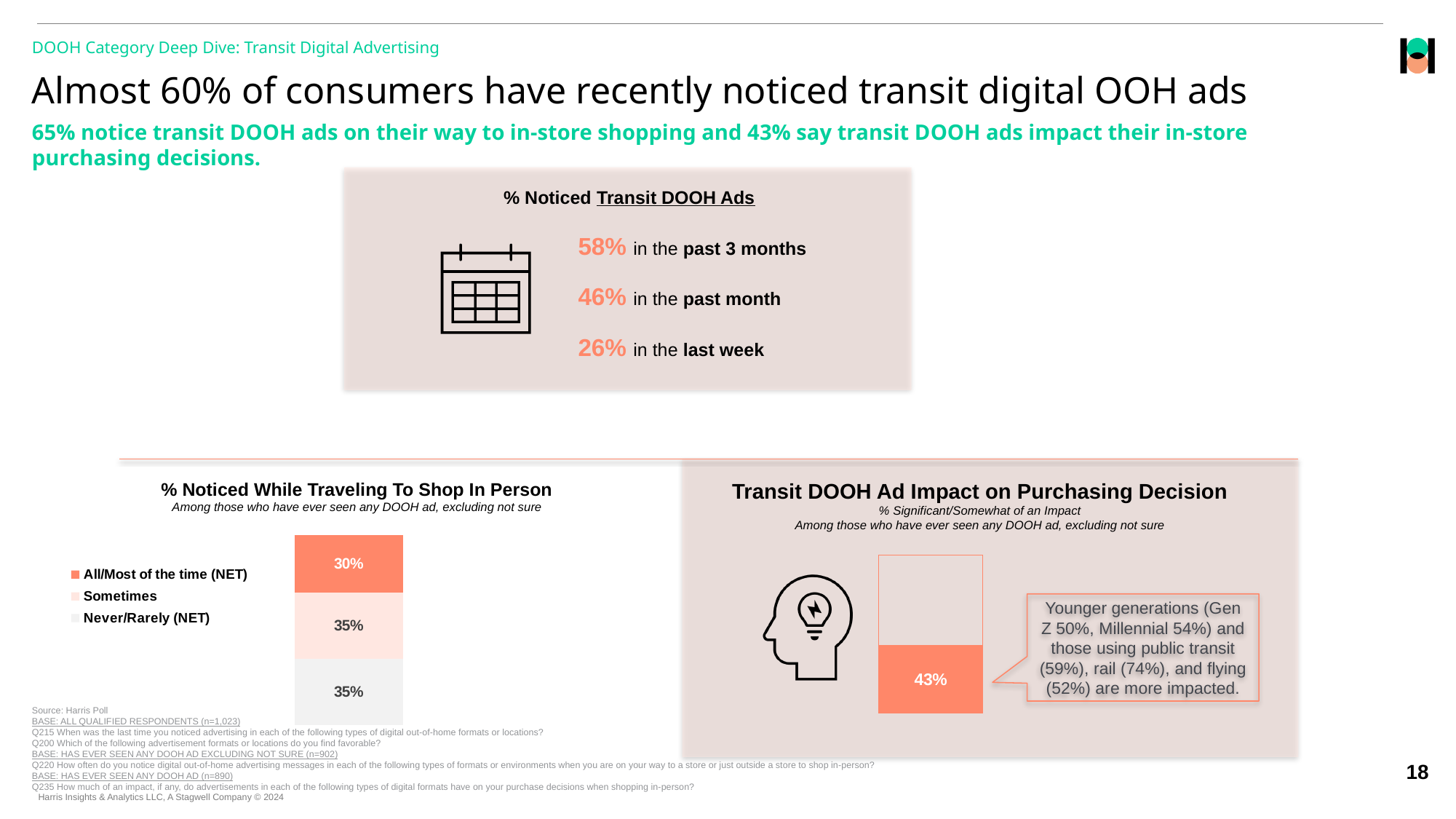
In the '% Noticed While Traveling To Shop In Person' chart, which segment is shown in the darkest orange colour? All/Most of the time (NET) In the '% Noticed While Traveling To Shop In Person' chart, what is the value for Sometimes? 35% What is the subtitle shown under the 'Transit DOOH Ad Impact on Purchasing Decision' chart title? % Significant/Somewhat of an Impact What kind of chart is the '% Noticed While Traveling To Shop In Person' chart? Stacked bar chart In the '% Noticed While Traveling To Shop In Person' chart, which is larger: Sometimes or All/Most of the time (NET)? Sometimes In the '% Noticed While Traveling To Shop In Person' chart, what is the value for All/Most of the time (NET)? 30% In the '% Noticed While Traveling To Shop In Person' chart, what is the value for Never/Rarely (NET)? 35% In the '% Noticed While Traveling To Shop In Person' chart, what is the total of the stacked bar? 100% In the '% Noticed While Traveling To Shop In Person' chart, which segment has the lowest value? All/Most of the time (NET) In the '% Noticed While Traveling To Shop In Person' chart, what is the difference between the Sometimes value and the All/Most of the time (NET) value? 5 percentage points In the 'Transit DOOH Ad Impact on Purchasing Decision' chart, what percentage is shown on the bar? 43% How many entries does the legend of the '% Noticed While Traveling To Shop In Person' chart list? 3